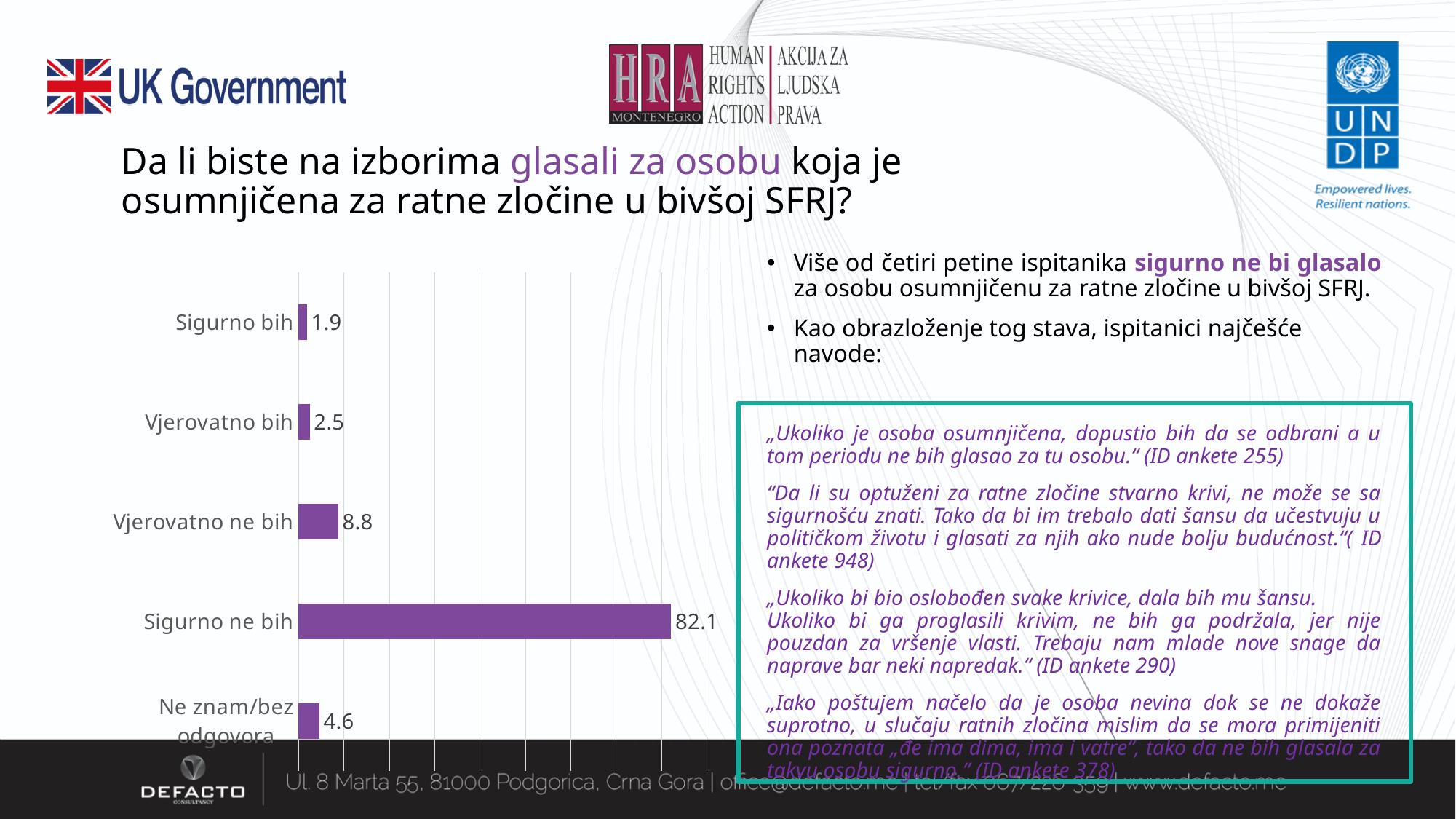
What value is shown for "Sigurno ne bih"? 82.1 What value is shown for "Vjerovatno ne bih"? 8.8 Which category has the highest value? Sigurno ne bih Which category has the lowest value? Sigurno bih What is the difference between the values for "Sigurno ne bih" and "Vjerovatno ne bih"? 73.3 How many categories are shown in the chart? 5 What value is shown for "Ne znam/bez odgovora"? 4.6 What kind of chart is shown on the slide? Bar chart What colour are the bars in the chart? Purple What value is shown for "Vjerovatno bih"? 2.5 What value is shown for "Sigurno bih"? 1.9 Which is larger, the value for "Ne znam/bez odgovora" or the value for "Vjerovatno bih"? Ne znam/bez odgovora